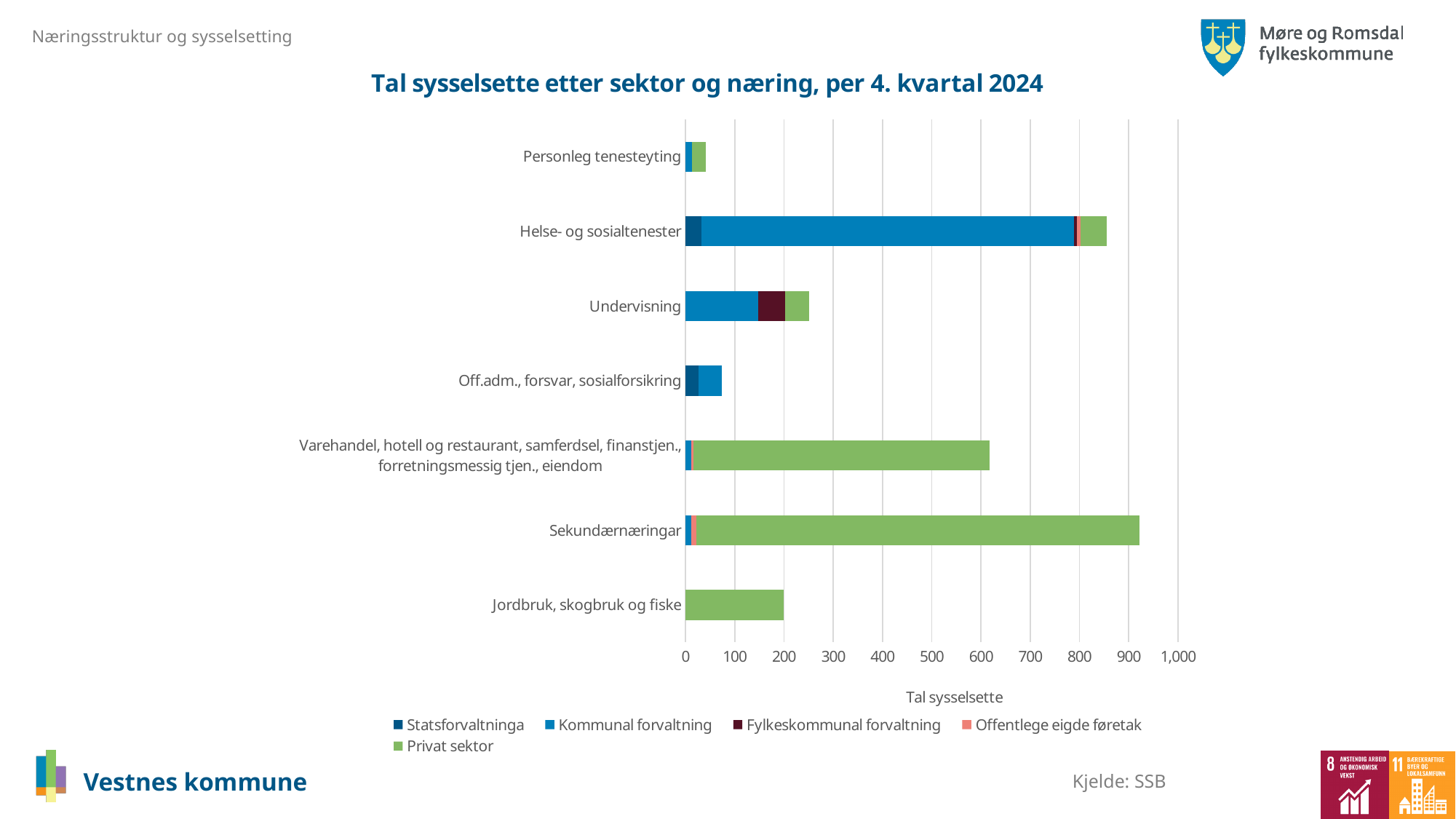
Which category has the shortest total bar? Personleg tenesteyting What is the title of the chart? Tal sysselsette etter sektor og næring, per 4. kvartal 2024 Which category has the longest total bar? Sekundærnæringar Is the total value for Sekundærnæringar greater or less than 900? greater How many series does the legend list? 5 Is the total value for Undervisning greater or less than 200? greater Is the total value for Helse- og sosialtenester greater or less than 800? greater How many categories (næringar) are shown on the y axis of the chart? 7 What kind of chart is shown on the slide? Stacked bar chart Which series is shown in green in the legend? Privat sektor Which has the larger total bar: Helse- og sosialtenester or Varehandel, hotell og restaurant, samferdsel, finanstjen., forretningsmessig tjen., eiendom? Helse- og sosialtenester